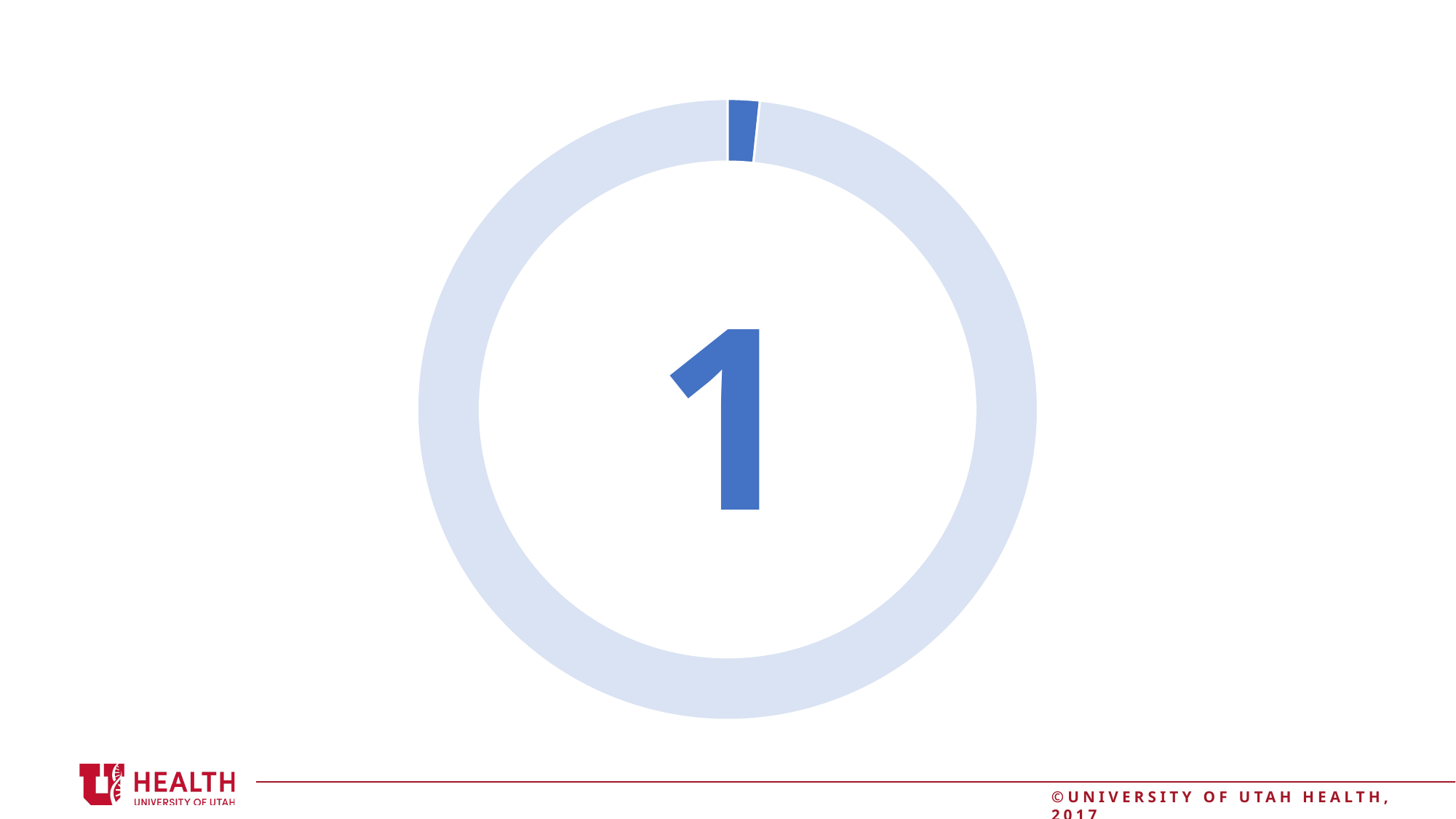
What number is printed in the centre of the doughnut chart? 1 What colour is the small slice at the top of the doughnut chart? dark blue Which slice of the doughnut chart is larger, the dark blue slice or the light blue slice? the light blue slice What kind of chart is shown on the slide? doughnut chart How many slices does the doughnut chart have? 2